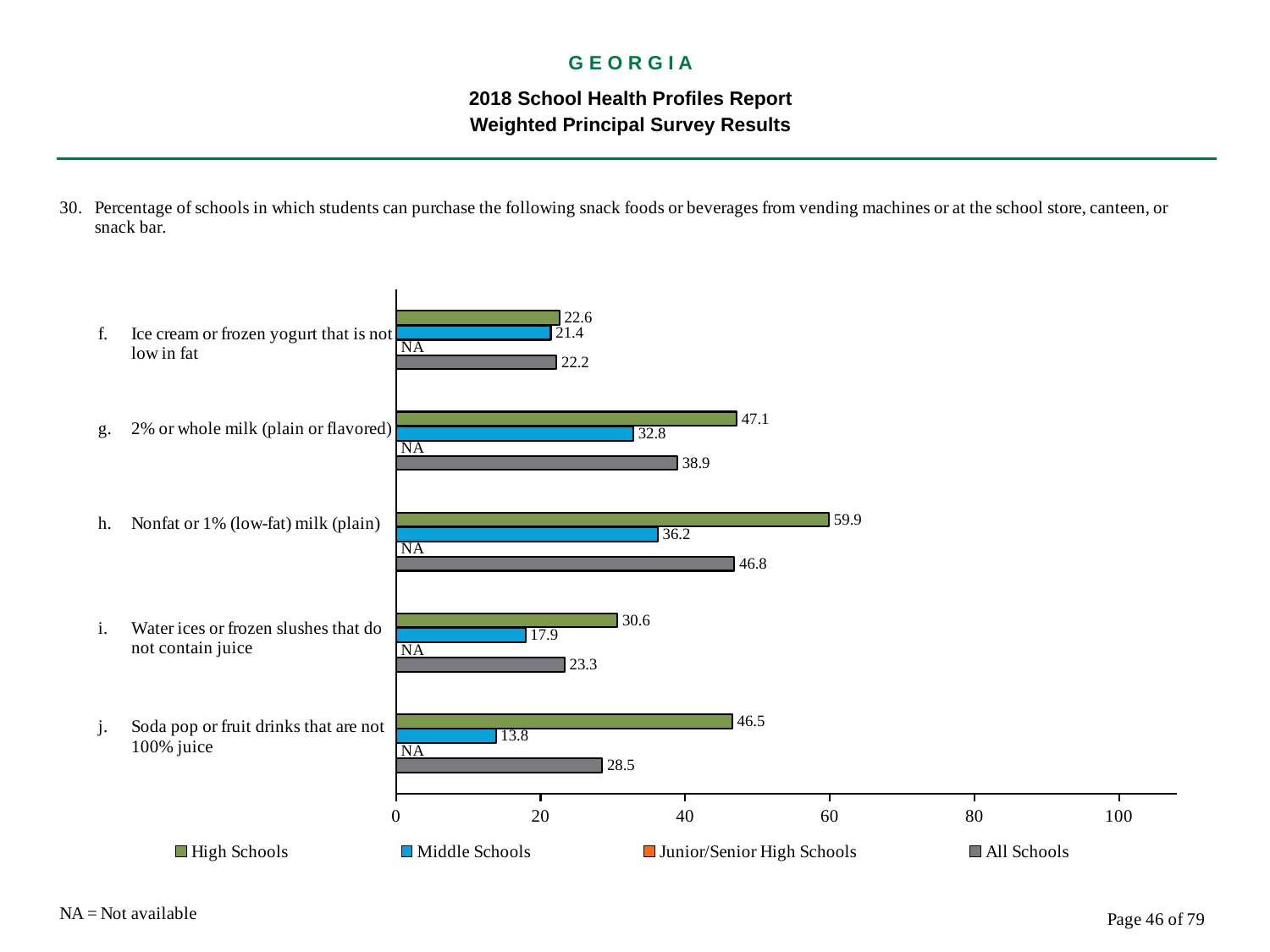
What is the High Schools value for "Nonfat or 1% (low-fat) milk (plain)"? 59.9 Which category has the lowest Middle Schools value? Soda pop or fruit drinks that are not 100% juice How many series does the legend list? 4 What is the difference between the High Schools and Middle Schools values for "Soda pop or fruit drinks that are not 100% juice"? 32.7 What value is shown for Junior/Senior High Schools for "Water ices or frozen slushes that do not contain juice"? NA Which category has the highest High Schools value? Nonfat or 1% (low-fat) milk (plain) Which is larger for "Ice cream or frozen yogurt that is not low in fat": the High Schools value or the All Schools value? High Schools What is the Middle Schools value for "Soda pop or fruit drinks that are not 100% juice"? 13.8 How many snack food or beverage categories are shown on the chart? 5 What is the All Schools value for "2% or whole milk (plain or flavored)"? 38.9 What kind of chart is shown on the slide? bar chart Is the All Schools value for "Nonfat or 1% (low-fat) milk (plain)" greater or less than 40? greater